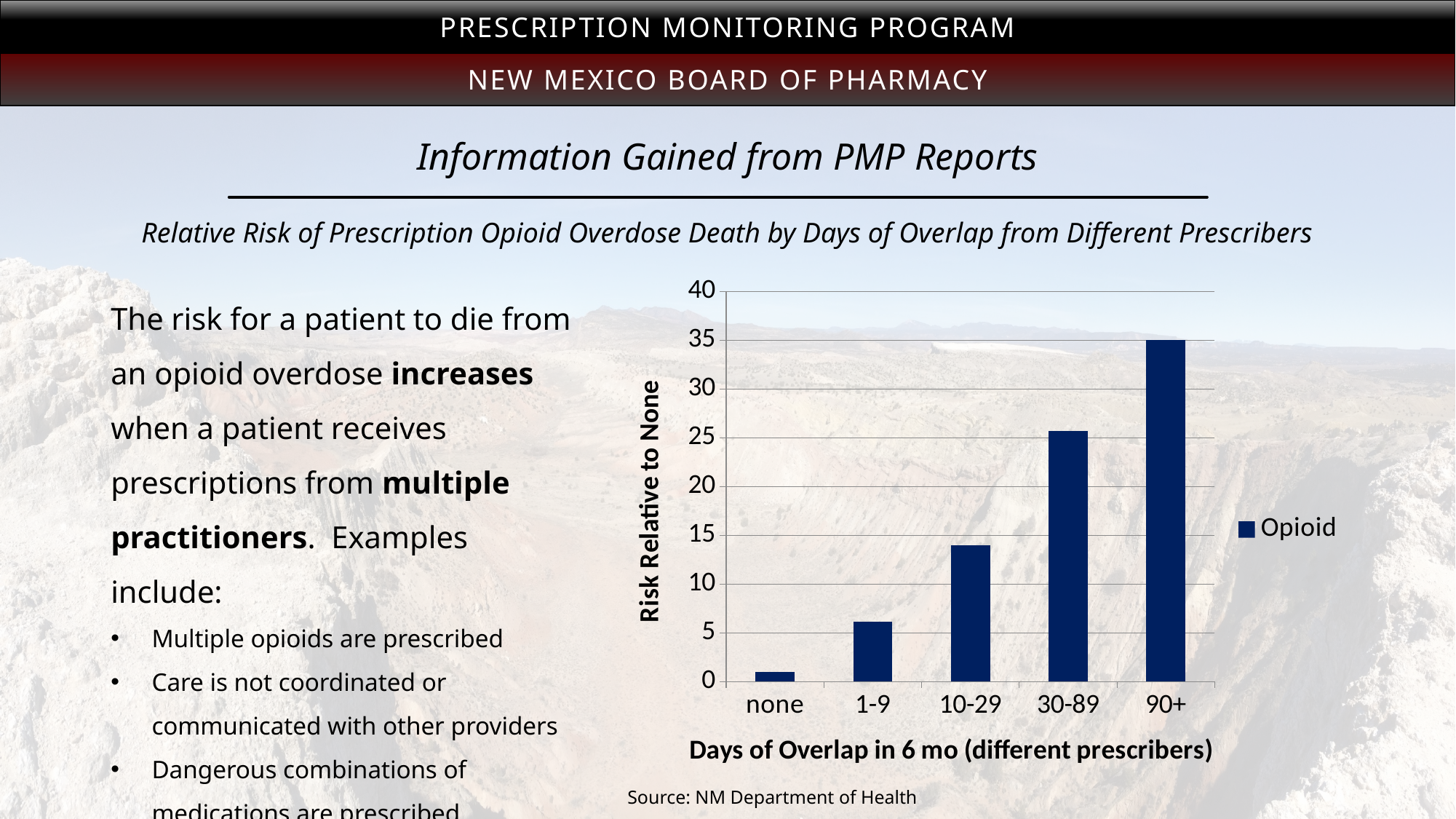
Which days-of-overlap category has the lowest risk relative to none? none Is the value for 10-29 days of overlap greater or less than 10? greater How many categories are shown on the x axis of the chart? 5 What series name is shown in the chart legend? Opioid Which has a higher risk relative to none: 10-29 days of overlap or 30-89 days of overlap? 30-89 Is the value for 30-89 days of overlap greater or less than 20? greater Is the value for 1-9 days of overlap greater or less than 10? less Which days-of-overlap category has the highest risk relative to none? 90+ What is the title of the chart's y axis? Risk Relative to None Do the values rise or fall as days of overlap increase along the x axis? rise How many series does the chart legend list? 1 What kind of chart is shown on the slide? bar chart